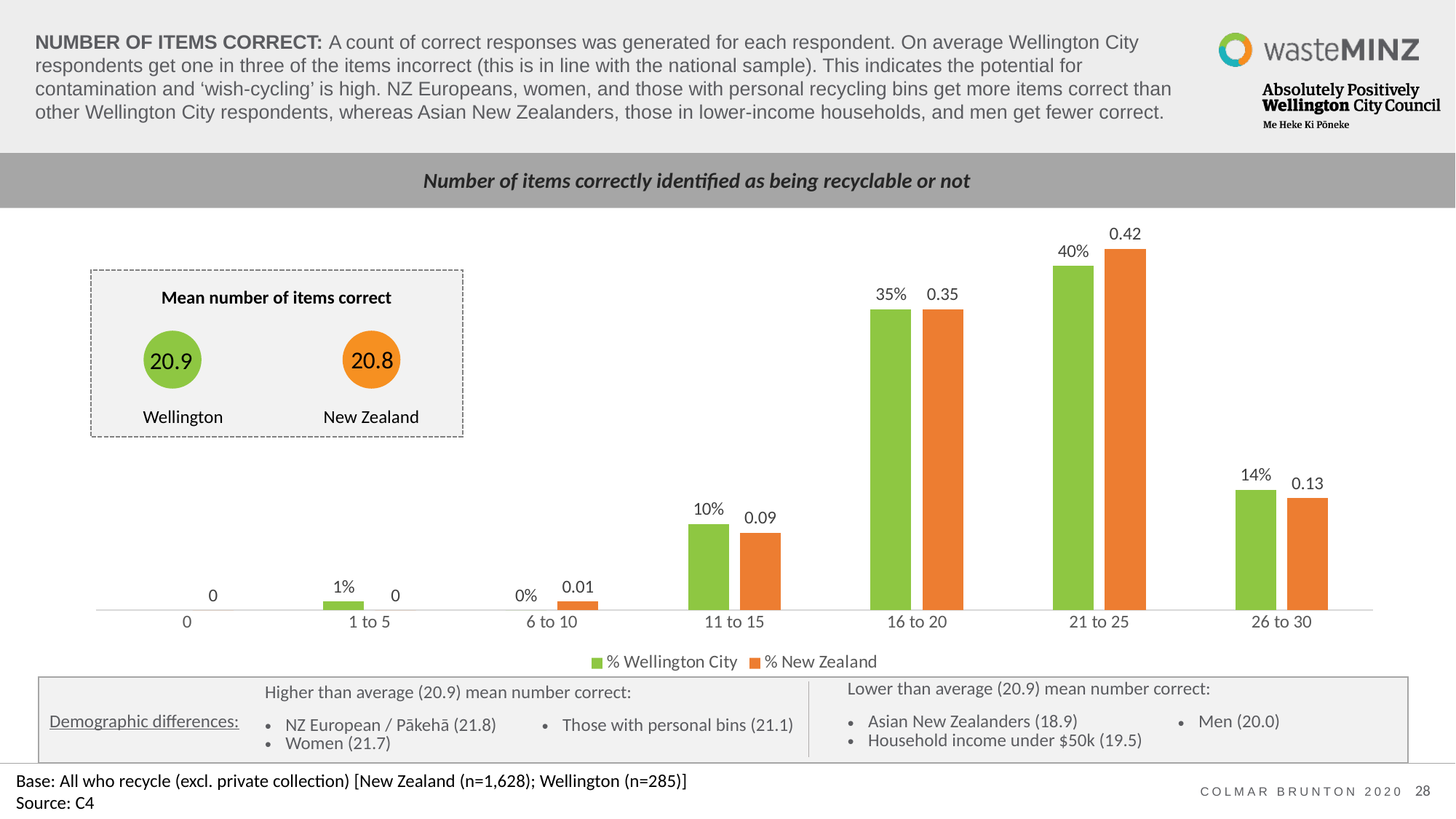
Which category has the highest % Wellington City value? 21 to 25 Which category has the highest % New Zealand value? 21 to 25 What is the difference between the % Wellington City values for the 21 to 25 and 16 to 20 categories? 5% What is the % New Zealand value for the 16 to 20 category? 0.35 What is the % Wellington City value for the 21 to 25 category? 40% Which is larger for the 26 to 30 category: the % Wellington City value or the % New Zealand value? % Wellington City What is the % Wellington City value for the 11 to 15 category? 10% What is the mean number of items correct for Wellington shown in the box on the chart? 20.9 What is the % New Zealand value for the 26 to 30 category? 0.13 How many categories are shown on the x axis of the chart? 7 What type of chart is shown on the slide? bar chart How many series does the chart legend list? 2